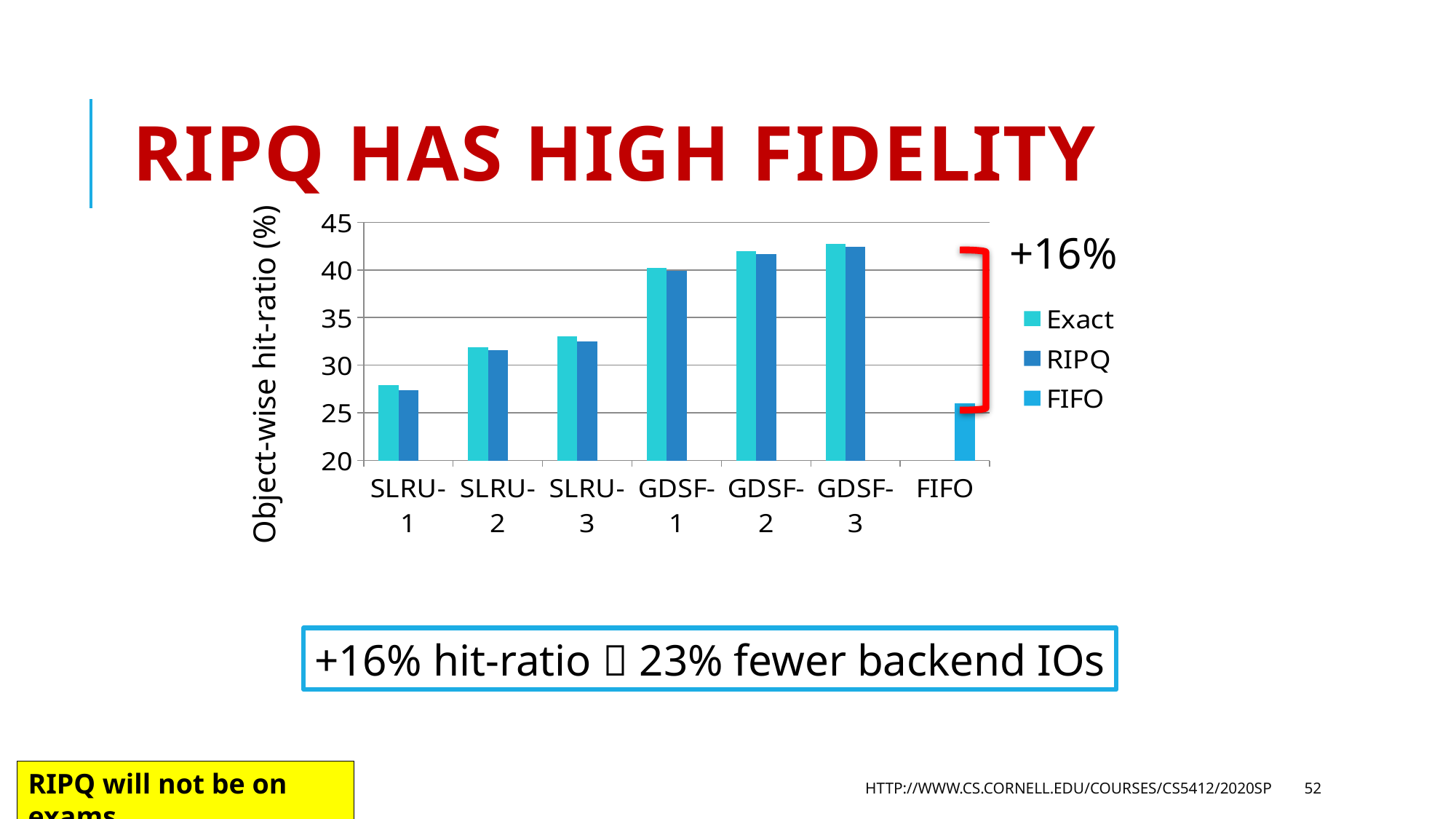
What kind of chart is shown on the slide? bar chart How many series does the chart legend list? 3 How many categories are shown along the x axis of the chart? 7 Do the Exact values rise or fall from SLRU-1 to GDSF-3? rise Is the Exact value for SLRU-1 greater or less than 30? less Is the FIFO value greater or less than 30? less Is the Exact value for GDSF-2 greater or less than 40? greater Which category has the highest Exact hit-ratio in the chart? GDSF-3 Which is larger, the Exact value for GDSF-1 or the Exact value for SLRU-3? GDSF-1 What is the label of the y axis of the chart? Object-wise hit-ratio (%) Which category has the lowest Exact hit-ratio in the chart? SLRU-1